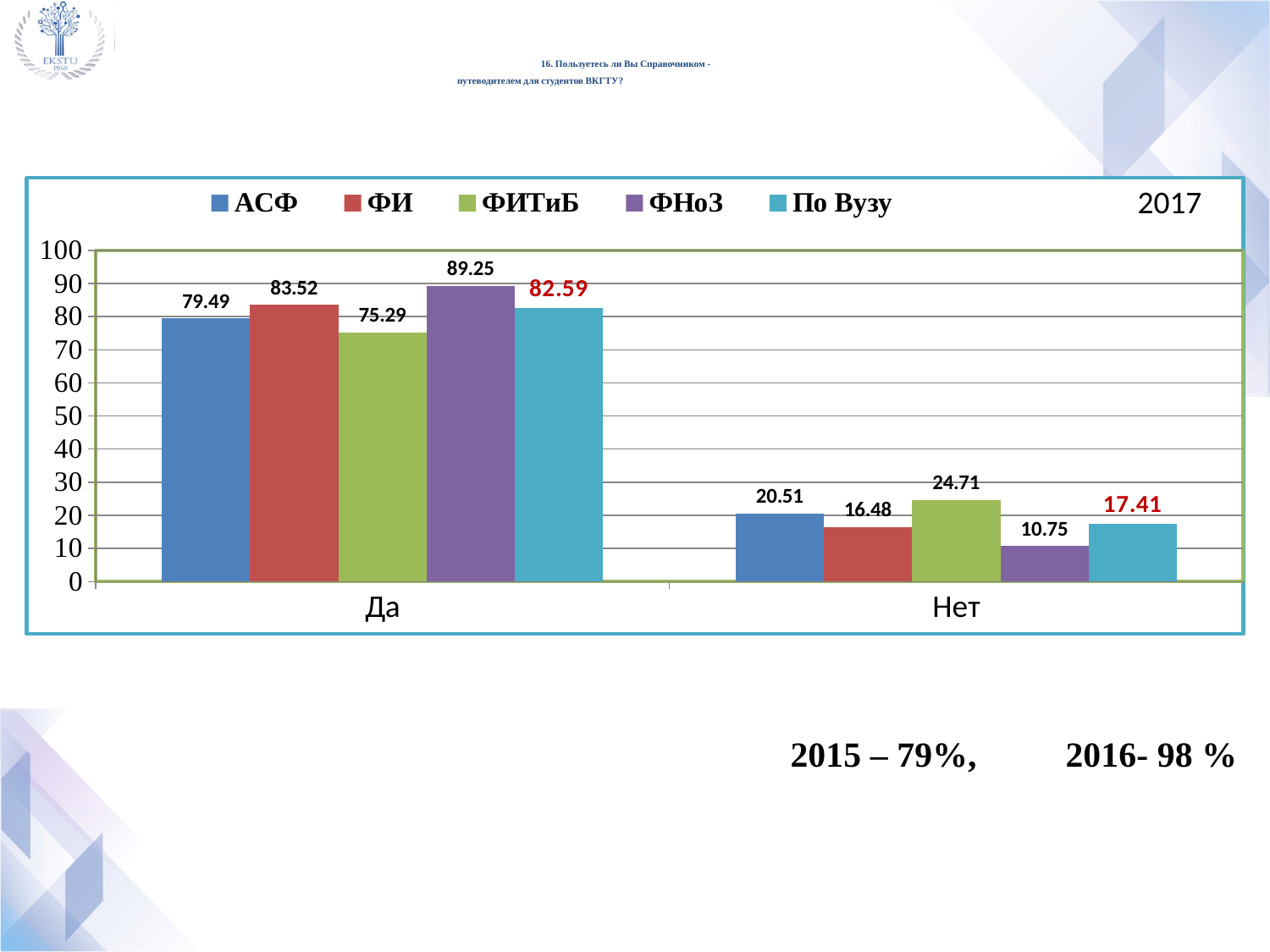
Which series has the lowest value in the Нет category? ФНоЗ What year is shown in the top right corner of the chart? 2017 What is the value for ФИТиБ in the Да category? 75.29 What is the difference between the ФИ and АСФ values in the Да category? 4.03 How many series does the legend list? 5 How many categories are shown on the x axis? 2 Which is larger in the Нет category: АСФ or ФИТиБ? ФИТиБ Is the value for ФИ in the Нет category greater or less than 20? less What kind of chart is shown on the slide? bar chart Which series has the highest value in the Да category? ФНоЗ What is the value for ФНоЗ in the Да category? 89.25 What is the value for По Вузу in the Нет category? 17.41